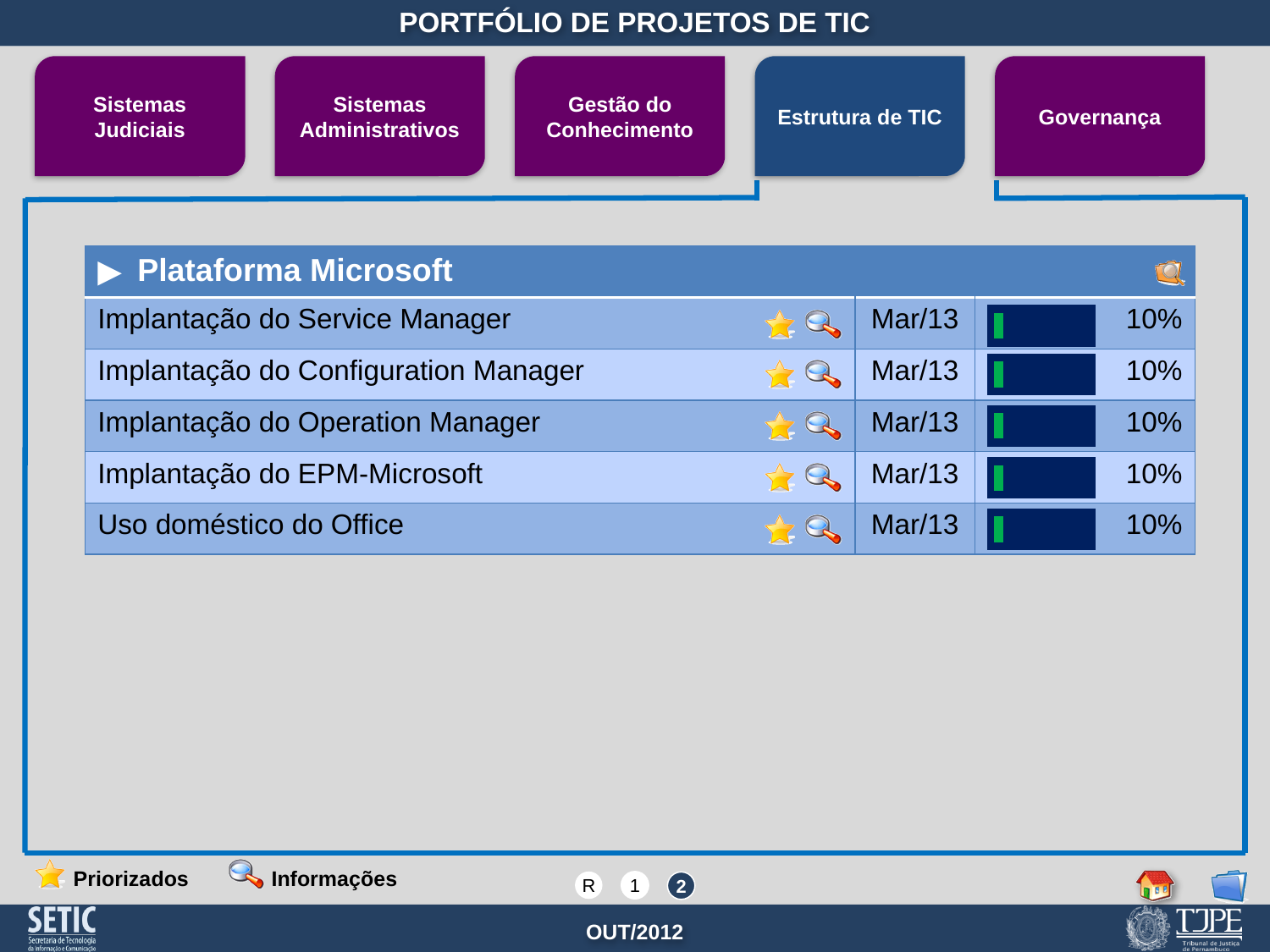
Do all five projects under Plataforma Microsoft show the same progress percentage? Yes What progress percentage is shown for Implantação do Configuration Manager? 10% What is the title of the group containing the progress bars? Plataforma Microsoft What is the difference between the progress of Implantação do Service Manager and Uso doméstico do Office? 0% What progress percentage is shown for Uso doméstico do Office? 10% What is the target date shown for Implantação do Operation Manager? Mar/13 What colour is the filled portion of the progress bars? Green What progress percentage is shown for Implantação do EPM-Microsoft? 10% What progress percentage is shown for Implantação do Service Manager? 10% How many projects are listed under Plataforma Microsoft? 5 Is the progress value for Implantação do Operation Manager greater or less than 50%? less